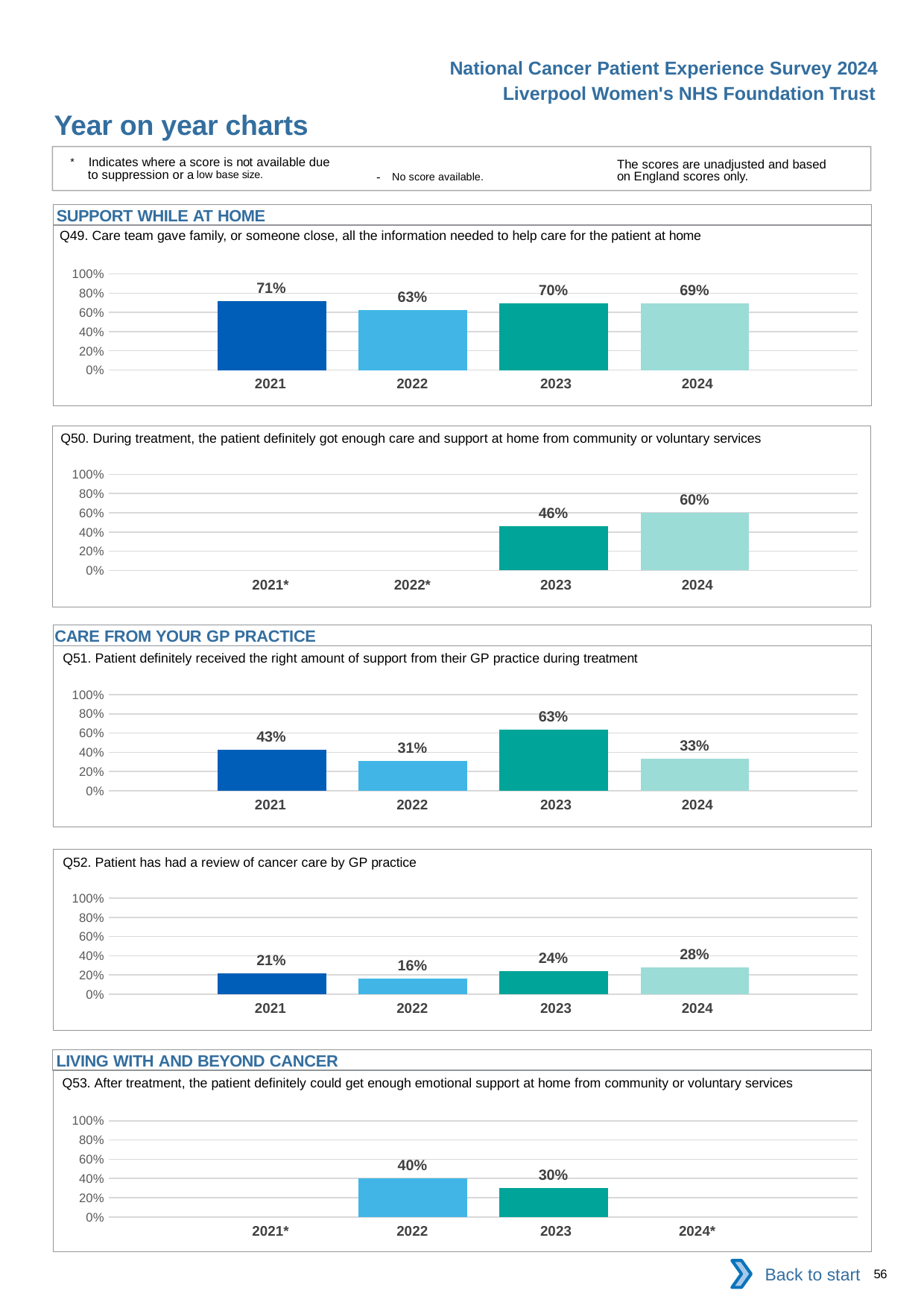
In the Q52 chart, is the value for 2024 greater or less than 40%? less In the Q50 chart, how many years have a bar plotted? 2 In the Q51 chart, what is the value for 2022? 31% In the Q49 chart, which year has the lowest value? 2022 In the Q51 chart, which year has the highest value? 2023 In the Q52 chart, which is larger, the value for 2021 or the value for 2023? 2023 In the Q50 chart, what is the difference between the 2024 and 2023 values? 14% In the Q53 chart, what is the value for 2023? 30% What kind of chart is the Q53 chart? bar chart In the Q52 chart, what is the difference between the 2024 and 2022 values? 12% In the Q49 chart, what is the value for 2021? 71% In the Q50 chart, what is the value for 2024? 60%